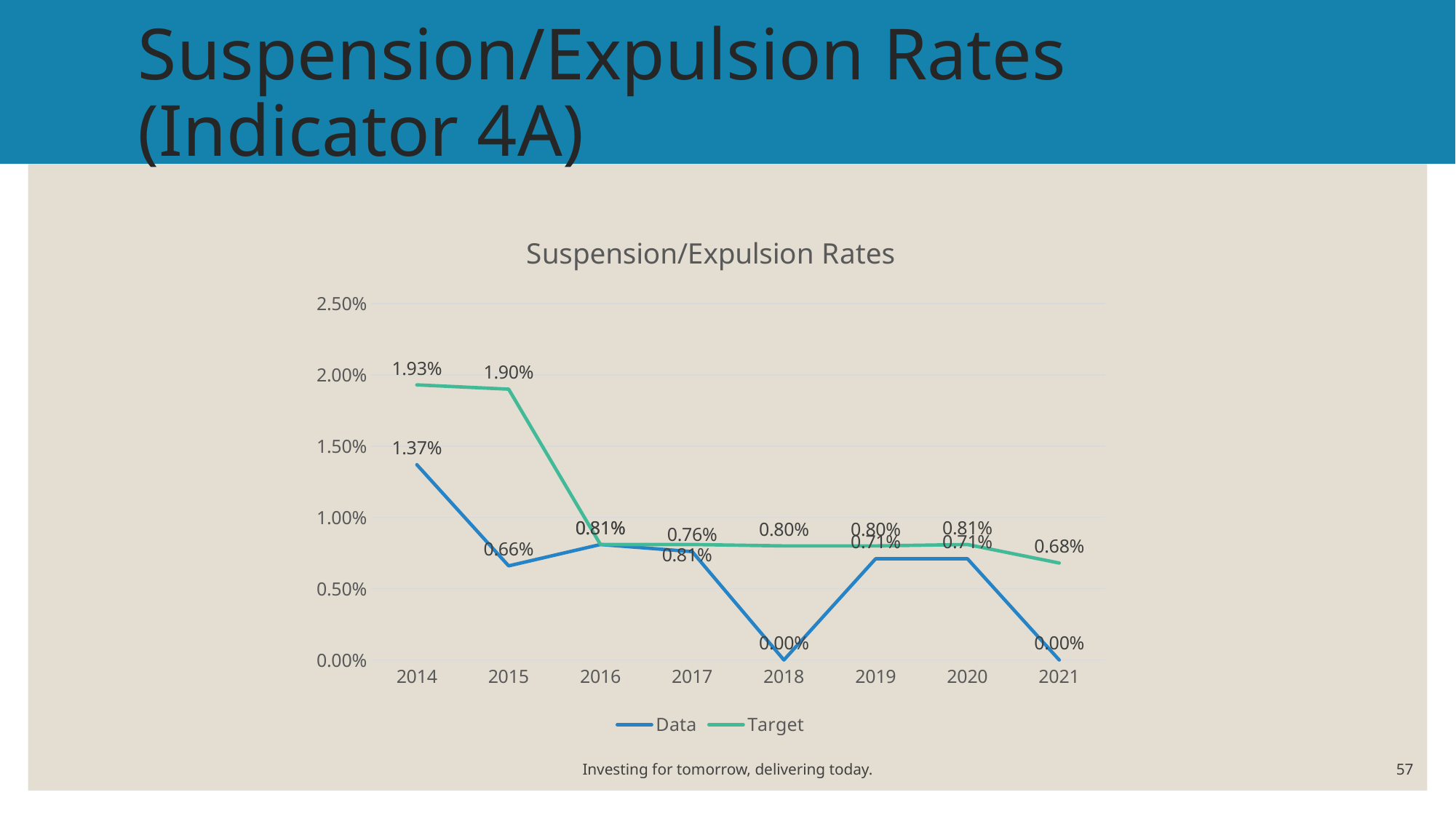
What is the Data value for 2014? 1.37% What type of chart is shown on the slide? line chart What is the Target value for 2021? 0.68% How many years are plotted along the x axis? 8 How many series does the legend list? 2 In which year is the Target value highest? 2014 What is the Data value for 2015? 0.66% What is the Target value for 2014? 1.93% What is the difference between the Target and Data values in 2014? 0.56% In 2015, which is larger, the Data value or the Target value? Target What is the Data value for 2018? 0.00% What is the Target value for 2015? 1.90%